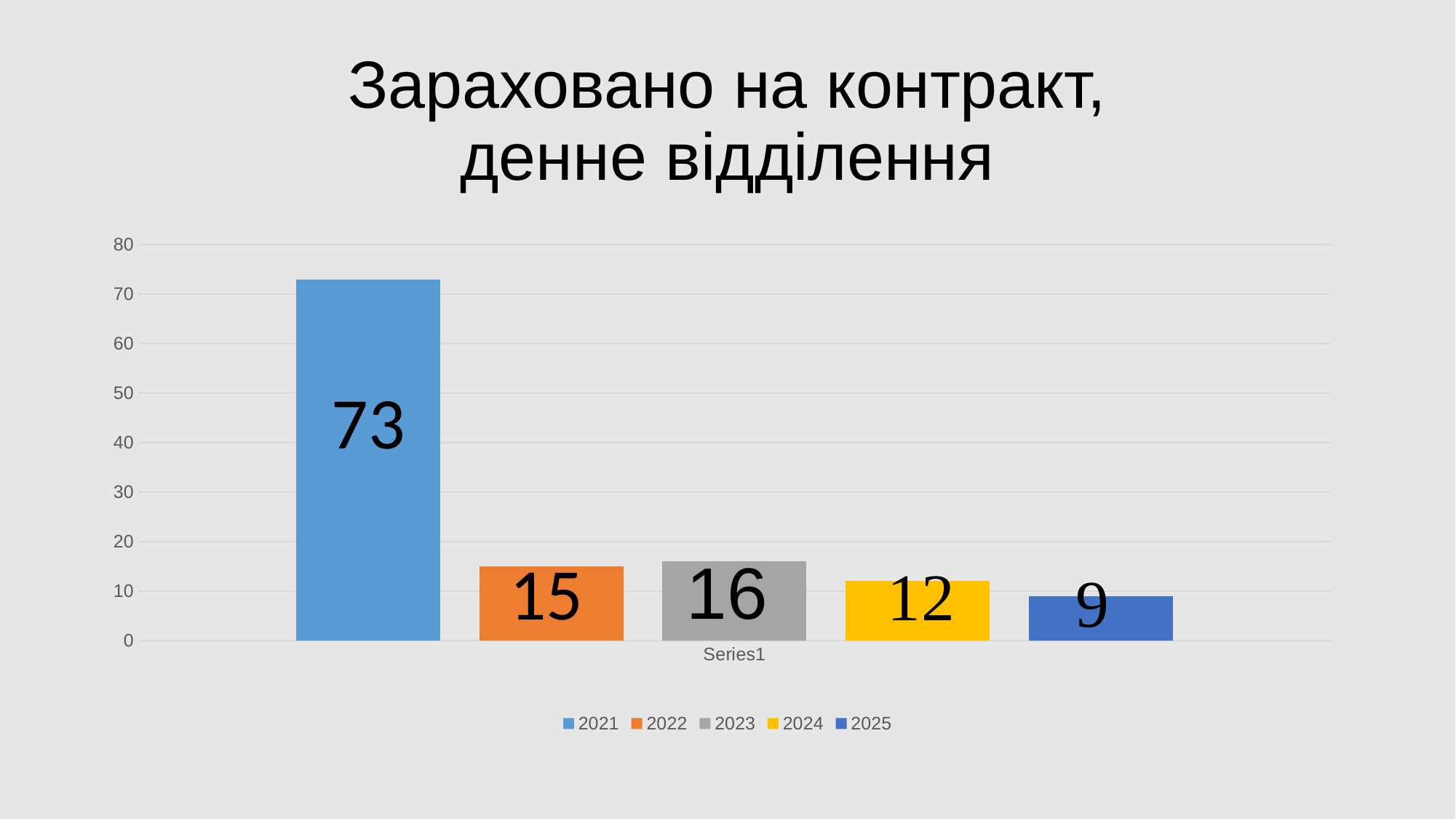
What is the value for 2025? 9 What kind of chart is shown on the slide? Bar chart What is the value for 2024? 12 What is the title of the chart? Зараховано на контракт, денне відділення Which year has the highest value? 2021 Which is larger, the value for 2023 or the value for 2024? 2023 What is the difference between the values for 2021 and 2022? 58 What is the value for 2023? 16 How many series does the legend list? 5 Which year has the lowest value? 2025 What is the value for 2021? 73 What is the value for 2022? 15